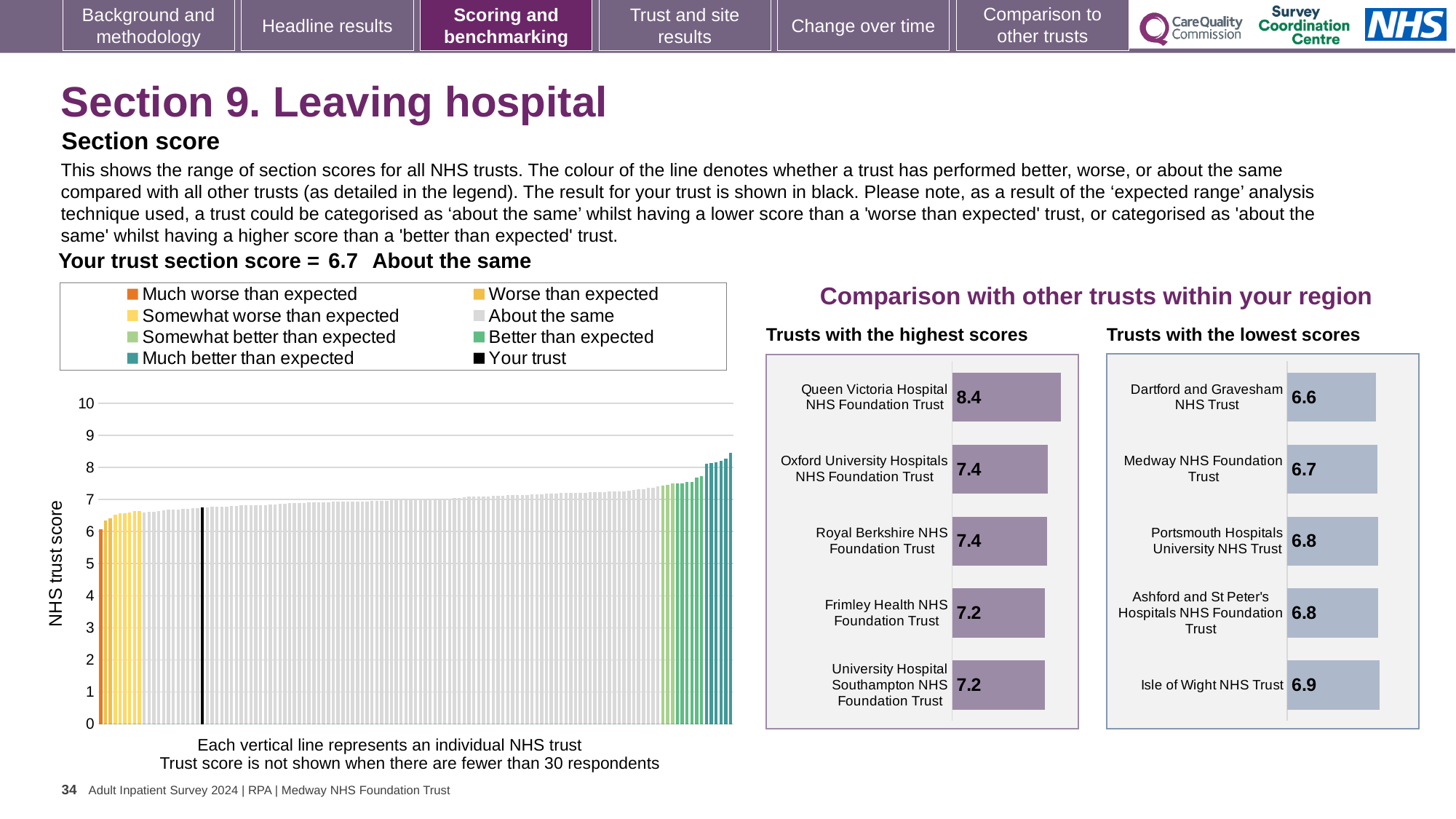
In the 'Trusts with the lowest scores' chart, which has the larger score: Portsmouth Hospitals University NHS Trust or Dartford and Gravesham NHS Trust? Portsmouth Hospitals University NHS Trust How many entries does the legend of the NHS trust score chart on the left list? 8 In the 'Trusts with the highest scores' chart, what is the difference between the scores of Queen Victoria Hospital NHS Foundation Trust and Frimley Health NHS Foundation Trust? 1.2 What kind of chart is the NHS trust score chart on the left of the slide? bar chart In the 'Trusts with the highest scores' chart, what is the score for Queen Victoria Hospital NHS Foundation Trust? 8.4 In the 'Trusts with the highest scores' chart, which trust has the highest score? Queen Victoria Hospital NHS Foundation Trust In the 'Trusts with the lowest scores' chart, which trust has the lowest score? Dartford and Gravesham NHS Trust How many trusts are shown in the 'Trusts with the highest scores' chart? 5 In the 'Trusts with the lowest scores' chart, what is the score for Isle of Wight NHS Trust? 6.9 In the NHS trust score chart on the left, do the values rise or fall from left to right along the x axis? rise In the NHS trust score chart on the left, what is the section score for your trust? 6.7 In the NHS trust score chart on the left, is the value of the tallest bar greater or less than 8? greater